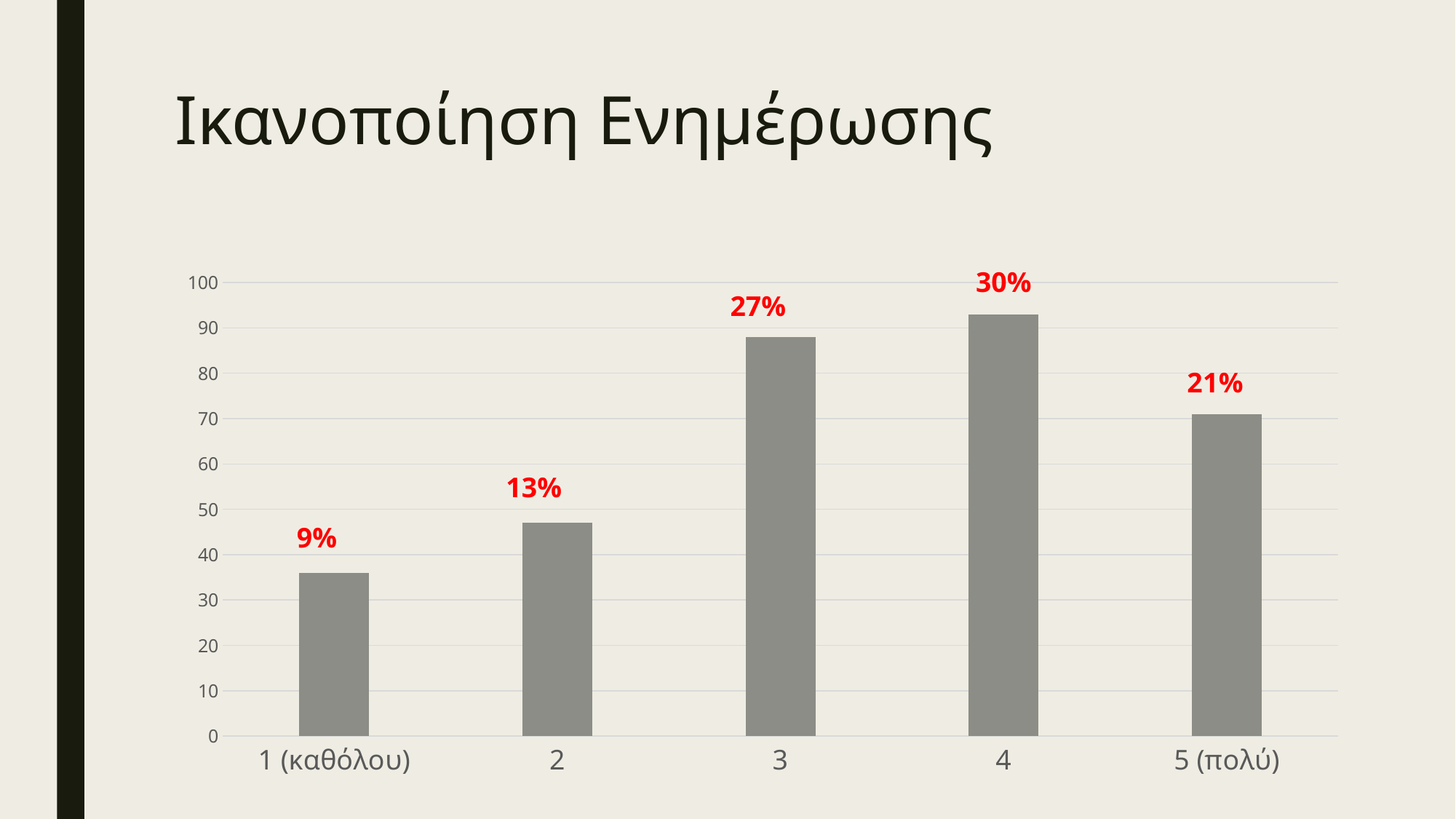
Which category has the lowest bar? 1 (καθόλου) Is the bar for category 3 greater or less than 80 on the vertical axis? greater Is the bar for category 2 greater or less than 50 on the vertical axis? less What is the data label shown above the bar for category 1 (καθόλου)? 9% What is the title of the slide? Ικανοποίηση Ενημέρωσης Which bar is taller, category 3 or category 5 (πολύ)? 3 What is the difference between the percentage labels for category 4 and category 1 (καθόλου)? 21% What kind of chart is shown on the slide? bar chart Which category has the highest bar? 4 What is the data label shown above the bar for category 4? 30% How many categories are shown on the x axis? 5 What is the data label shown above the bar for category 5 (πολύ)? 21%